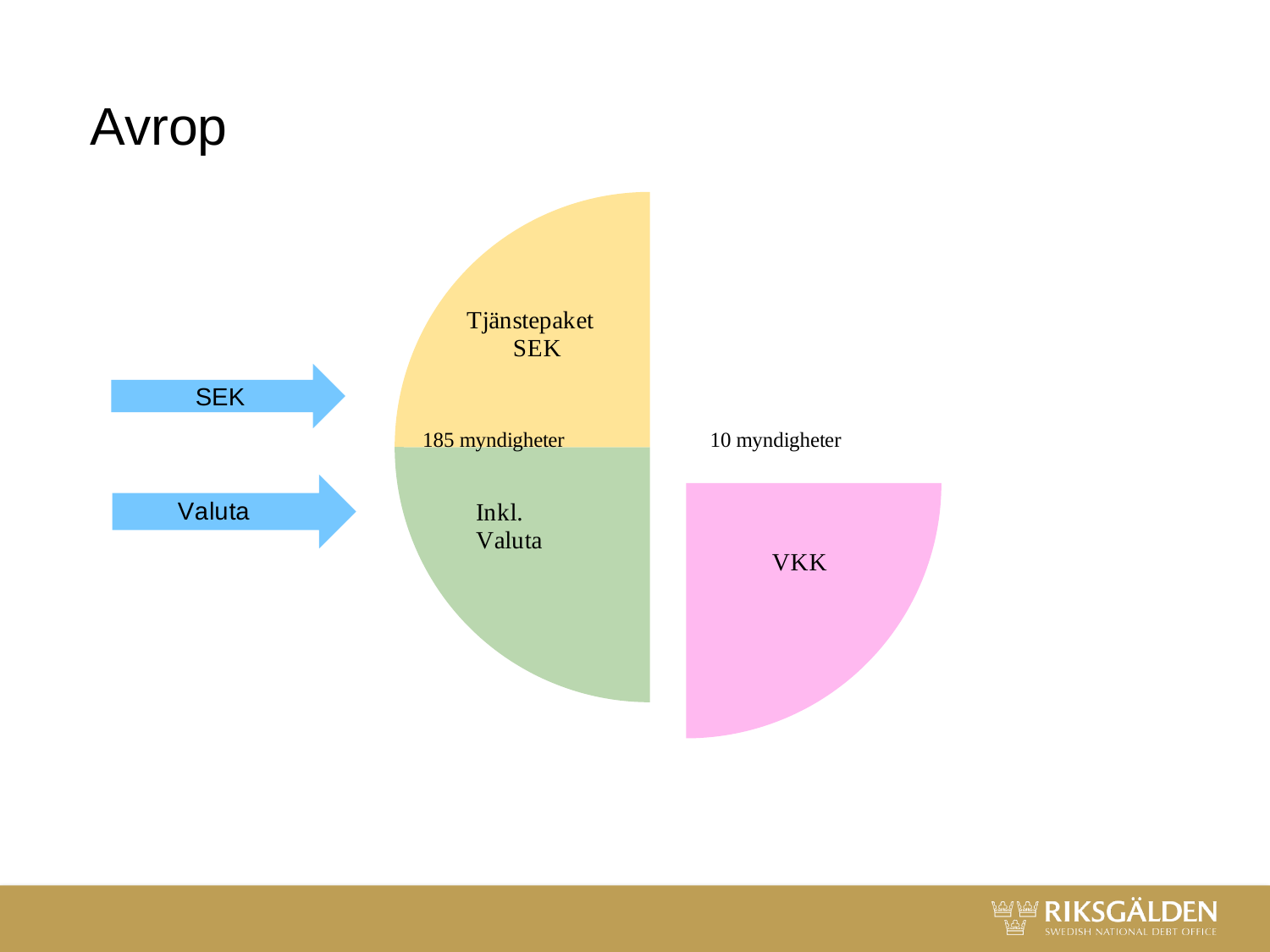
How many segments does the pie chart have? 3 Which is larger: the number of myndigheter labelled on the left half of the pie or the number labelled next to VKK? the left half (185 myndigheter) How many myndigheter are labelled on the left half of the pie (Tjänstepaket SEK / Inkl. Valuta)? 185 myndigheter Is the number of myndigheter labelled next to VKK greater or less than 100? less What is the difference between the 185 myndigheter label and the 10 myndigheter label? 175 What colour is the segment labelled Tjänstepaket SEK? yellow How many myndigheter are labelled next to the VKK segment? 10 myndigheter What is the label of the pink segment of the pie chart? VKK What is the title of the slide containing the pie chart? Avrop What kind of chart is shown on the slide? pie chart